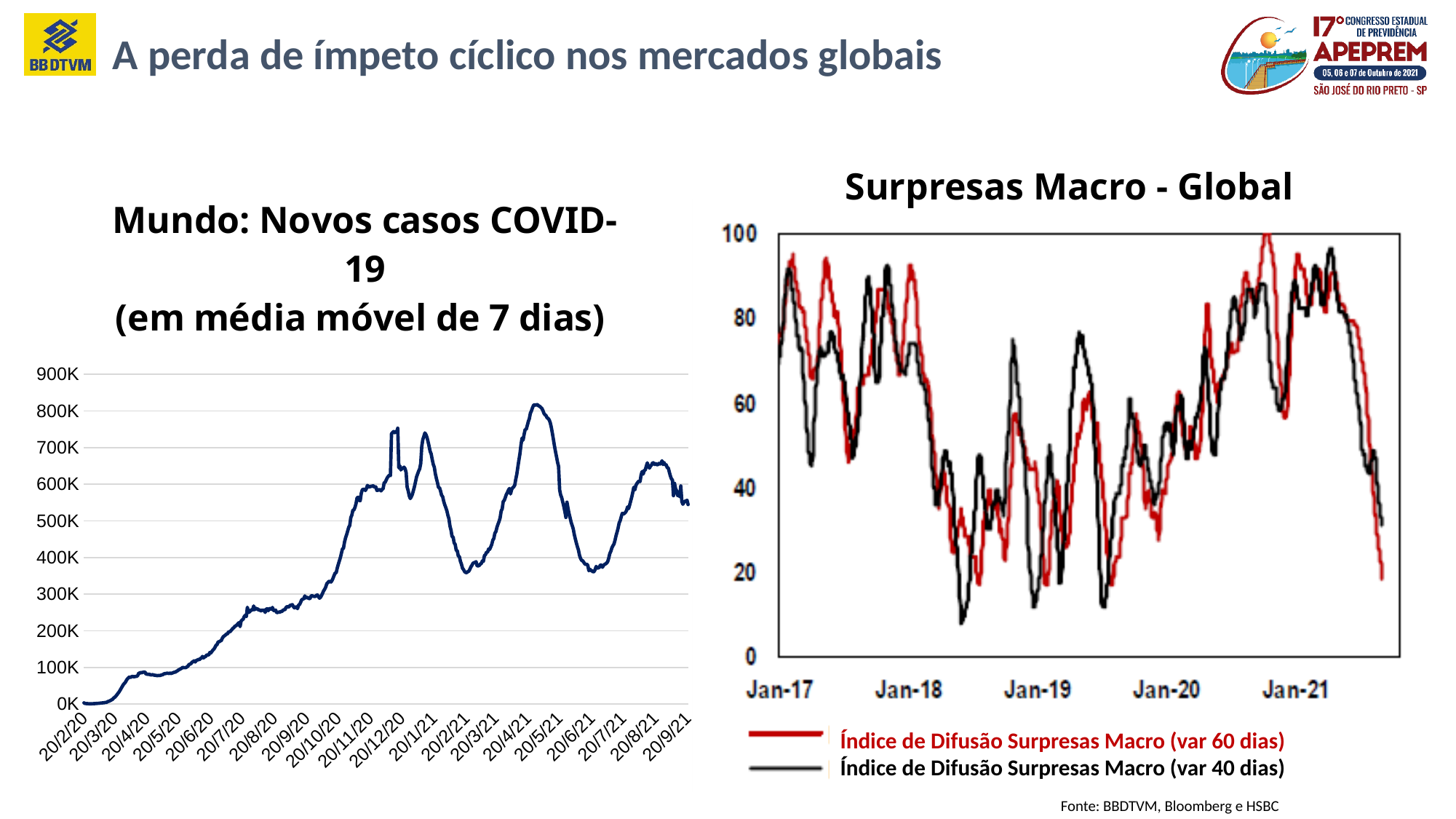
How many series does the legend of the 'Surpresas Macro - Global' chart list? 2 In the 'Mundo: Novos casos COVID-19' chart, is the value at 20/9/21 greater or less than 500K? greater In the 'Mundo: Novos casos COVID-19' chart, is the peak value around 20/4/21 greater or less than 800K? greater What kind of chart is the 'Surpresas Macro - Global' chart on the right? line chart What kind of chart is the 'Mundo: Novos casos COVID-19' chart on the left? line chart How many year labels are shown on the x axis of the 'Surpresas Macro - Global' chart? 5 In the 'Mundo: Novos casos COVID-19' chart, do the values rise or fall between 20/2/20 and 20/11/20? rise In the 'Surpresas Macro - Global' chart, which series is drawn in red? Índice de Difusão Surpresas Macro (var 60 dias) What is the title of the chart on the right side of the slide? Surpresas Macro - Global In the 'Mundo: Novos casos COVID-19' chart, is the value at 20/7/20 greater or less than 300K? less